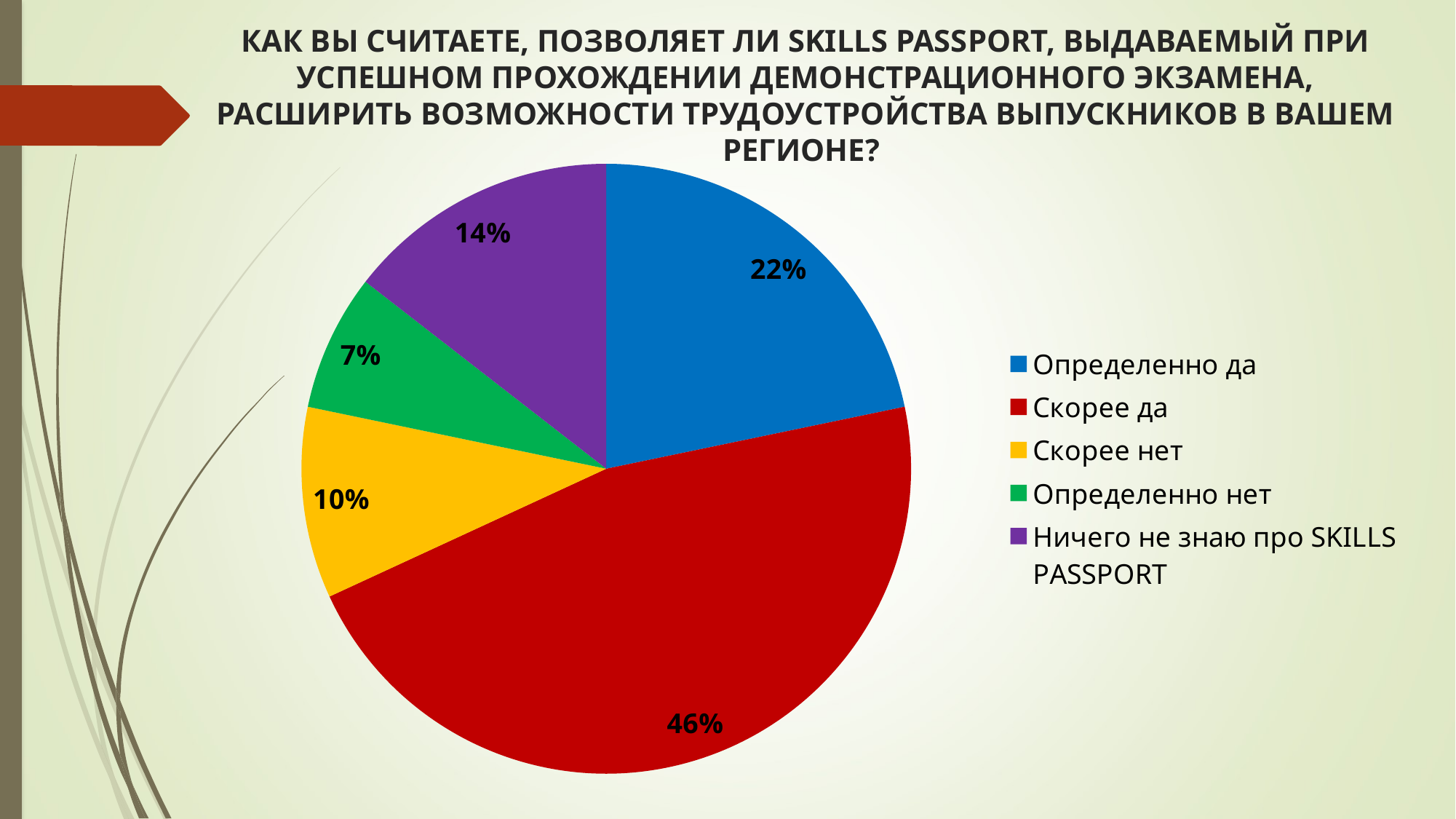
Which category has the largest slice of the pie? Скорее да What is the difference between the shares of "Скорее да" and "Определенно да"? 24% How many categories does the pie chart show? 5 What share of the pie does "Скорее да" represent? 46% What is the value shown for "Определенно да"? 22% What kind of chart is shown on the slide? Pie chart Which category has the smallest slice of the pie? Определенно нет What is the value shown for "Скорее нет"? 10% What is the value shown for "Ничего не знаю про SKILLS PASSPORT"? 14% Which is larger, the share for "Скорее нет" or the share for "Ничего не знаю про SKILLS PASSPORT"? Ничего не знаю про SKILLS PASSPORT What colour is the slice for "Скорее нет"? Yellow What is the value shown for "Определенно нет"? 7%